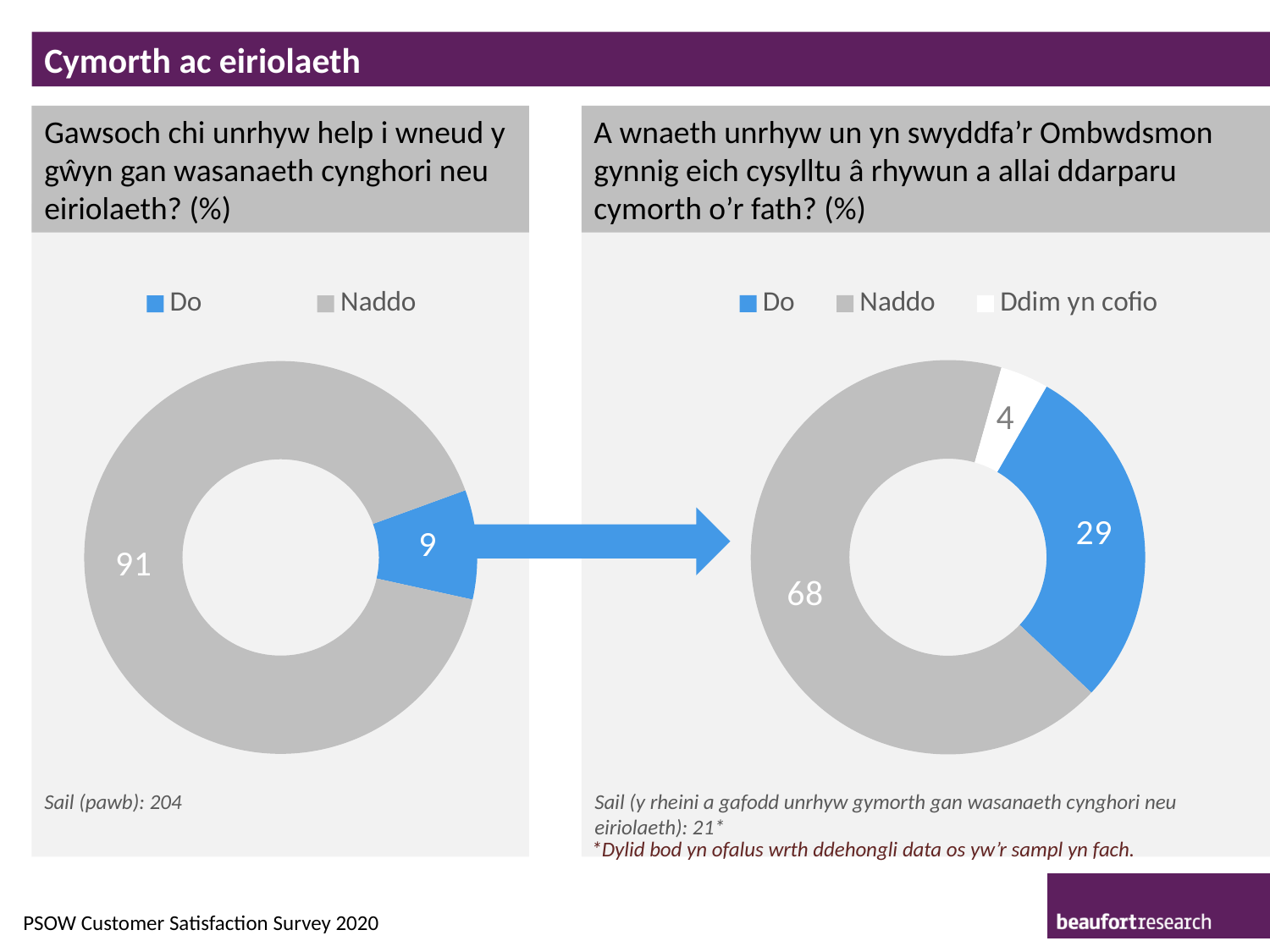
In the right chart, what is the difference between the values for Naddo and Do? 39 In the right chart, what is the value for Naddo? 68 In the left chart, what is the difference between the values for Naddo and Do? 82 In the right chart (A wnaeth unrhyw un yn swyddfa'r Ombwdsmon gynnig eich cysylltu â rhywun a allai ddarparu cymorth o'r fath?), what is the value for Do? 29 In the right chart, which is larger, Do or Ddim yn cofio? Do In the right chart, which category has the lowest value? Ddim yn cofio What type of chart is the left chart? Doughnut chart In the left chart (Gawsoch chi unrhyw help i wneud y gŵyn gan wasanaeth cynghori neu eiriolaeth?), what is the value for Do? 9 How many categories does the legend of the right chart list? 3 In the right chart, which category has the highest value? Naddo In the right chart, what is the value for Ddim yn cofio? 4 In the left chart, what is the value for Naddo? 91